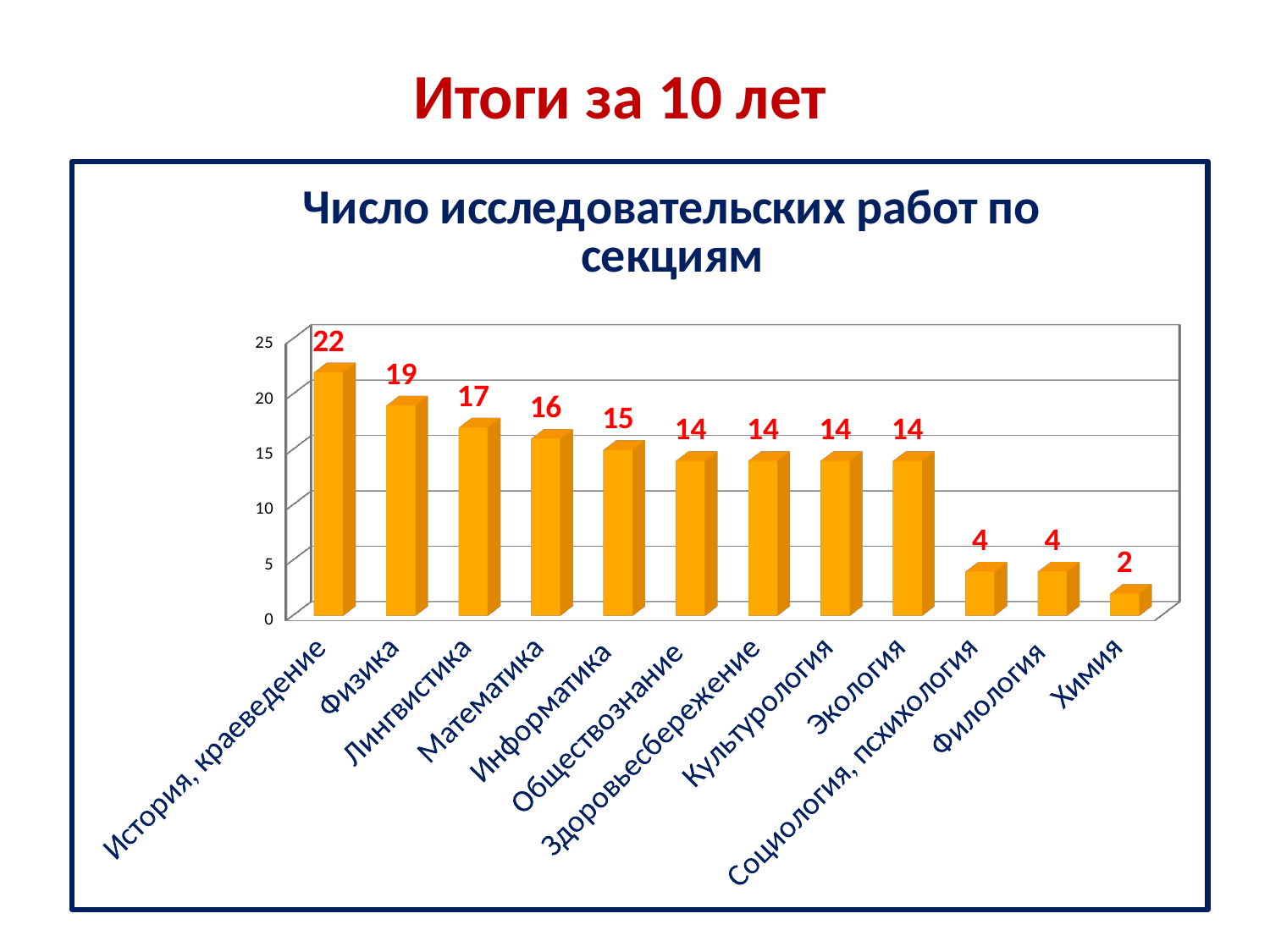
What is the difference between the values for Математика and Филология? 12 What kind of chart is this? bar chart What is the title of the chart? Число исследовательских работ по секциям How many categories are shown on the x axis? 12 What is the value for Информатика? 15 Do the values rise or fall from left to right along the x axis? fall What is the value for Химия? 2 What is the difference between the values for История, краеведение and Физика? 3 What is the value for Физика? 19 Which category has the highest value? История, краеведение Which is larger, the value for Лингвистика or the value for Экология? Лингвистика Which category has the lowest value? Химия